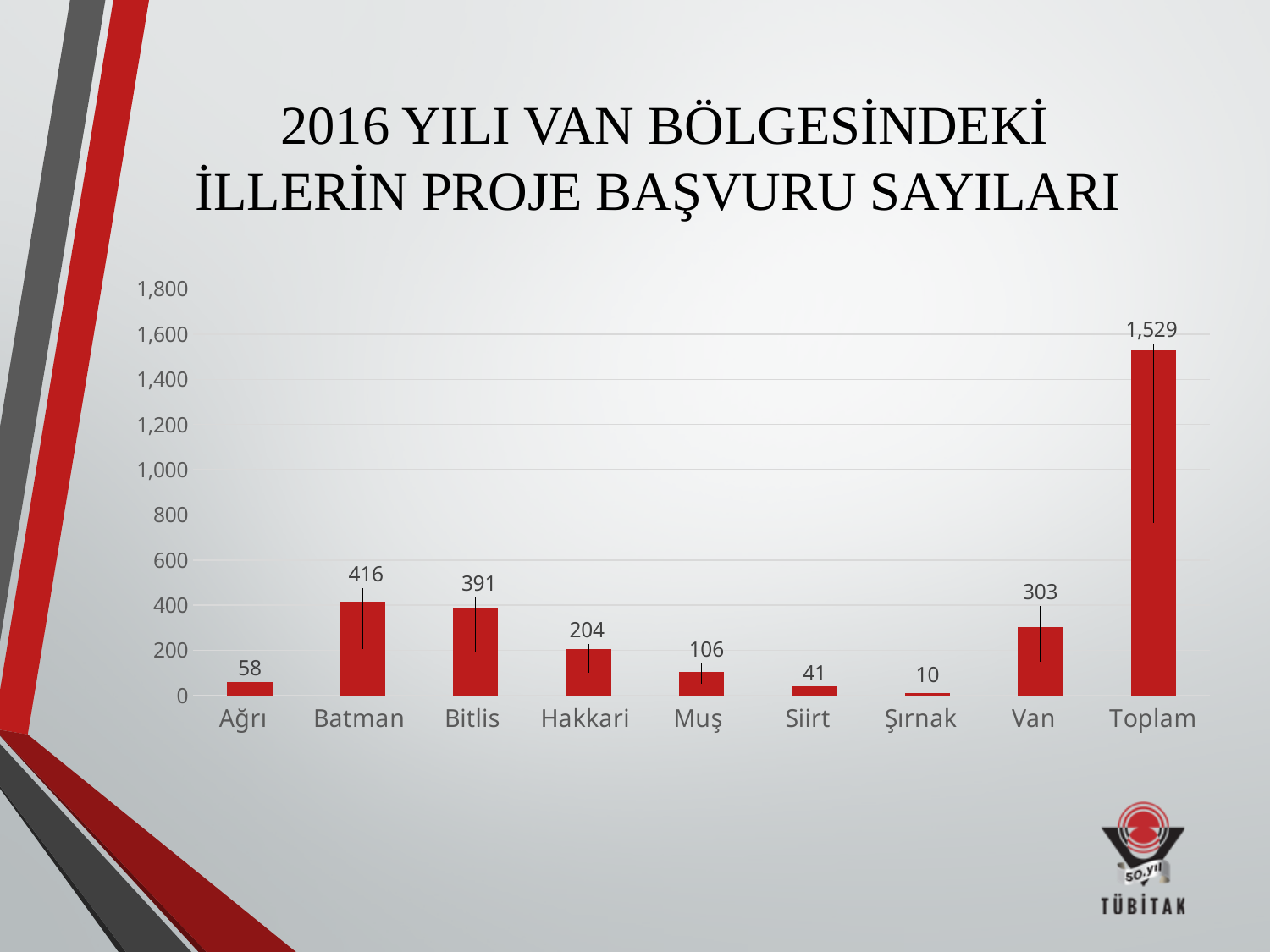
What is the value for Batman? 416 What is the difference between the values for Muş and Siirt? 65 Which is larger, the value for Van or the value for Hakkari? Van Which category has the lowest value? Şırnak Which province (excluding Toplam) has the highest value? Batman What kind of chart is shown on the slide? bar chart How many categories are shown on the x axis? 9 What is the title of the slide? 2016 YILI VAN BÖLGESİNDEKİ İLLERİN PROJE BAŞVURU SAYILARI What is the difference between the values for Batman and Bitlis? 25 What is the value for Hakkari? 204 What is the value for Toplam? 1,529 Is the value for Bitlis greater or less than 200? greater